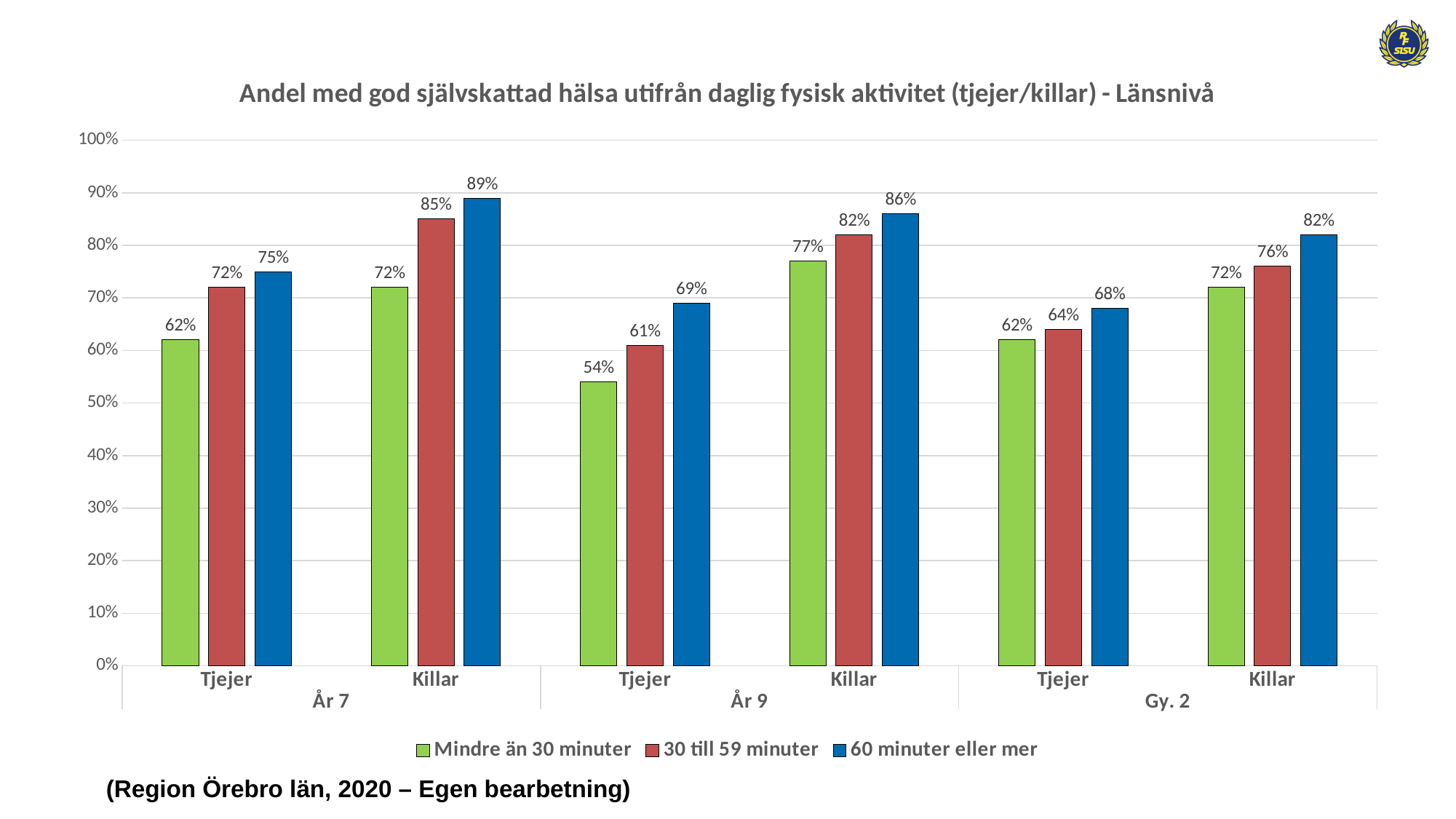
What colour represents the series '60 minuter eller mer'? Blue Which group has the lowest value for the series 'Mindre än 30 minuter'? Tjejer, År 9 What is the difference between the '60 minuter eller mer' value and the 'Mindre än 30 minuter' value for Tjejer in År 9? 15% What is the value for Tjejer in Gy. 2 for the series '30 till 59 minuter'? 64% How many series does the legend list? 3 Within each group, do the values rise or fall from 'Mindre än 30 minuter' to '60 minuter eller mer'? Rise What is the value for Killar in År 9 for the series 'Mindre än 30 minuter'? 77% Which group has the highest value for the series '60 minuter eller mer'? Killar, År 7 What kind of chart is shown on the slide? Bar chart What is the value for Tjejer in År 7 for the series '60 minuter eller mer'? 75% Which is larger: the '30 till 59 minuter' value for Killar in År 7 or for Killar in Gy. 2? Killar in År 7 How many groups (Tjejer/Killar categories) are shown on the x axis? 6